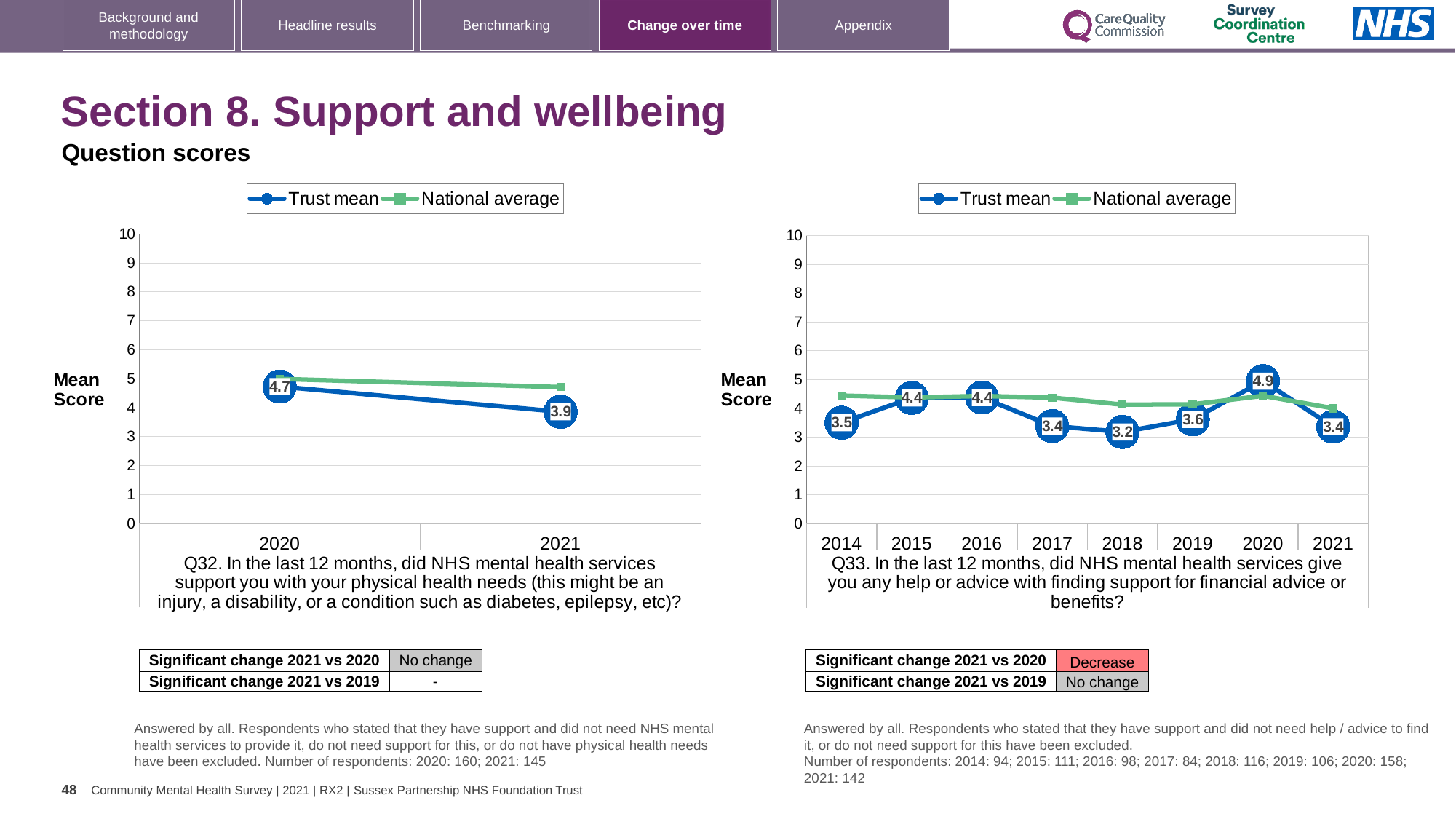
In the Q33 chart on the right, is the Trust mean higher in 2015 or in 2017? 2015 In the Q32 chart on the left, by how much did the Trust mean fall from 2020 to 2021? 0.8 What type of chart is used for Q33 on the right? Line chart How many years are shown on the x axis of the Q33 chart on the right? 8 In the Q32 chart on the left, what is the Trust mean for 2020? 4.7 In the Q33 chart on the right, which year has the highest Trust mean? 2020 How many series does the legend of the Q32 chart on the left list? 2 In the Q33 chart on the right, what is the difference between the Trust mean in 2020 and in 2021? 1.5 In the Q33 chart on the right, is the National average for 2014 greater or less than 4? greater In the Q33 chart on the right, what is the Trust mean for 2020? 4.9 In the Q33 chart on the right, which year has the lowest Trust mean? 2018 In the Q32 chart on the left, what is the Trust mean for 2021? 3.9